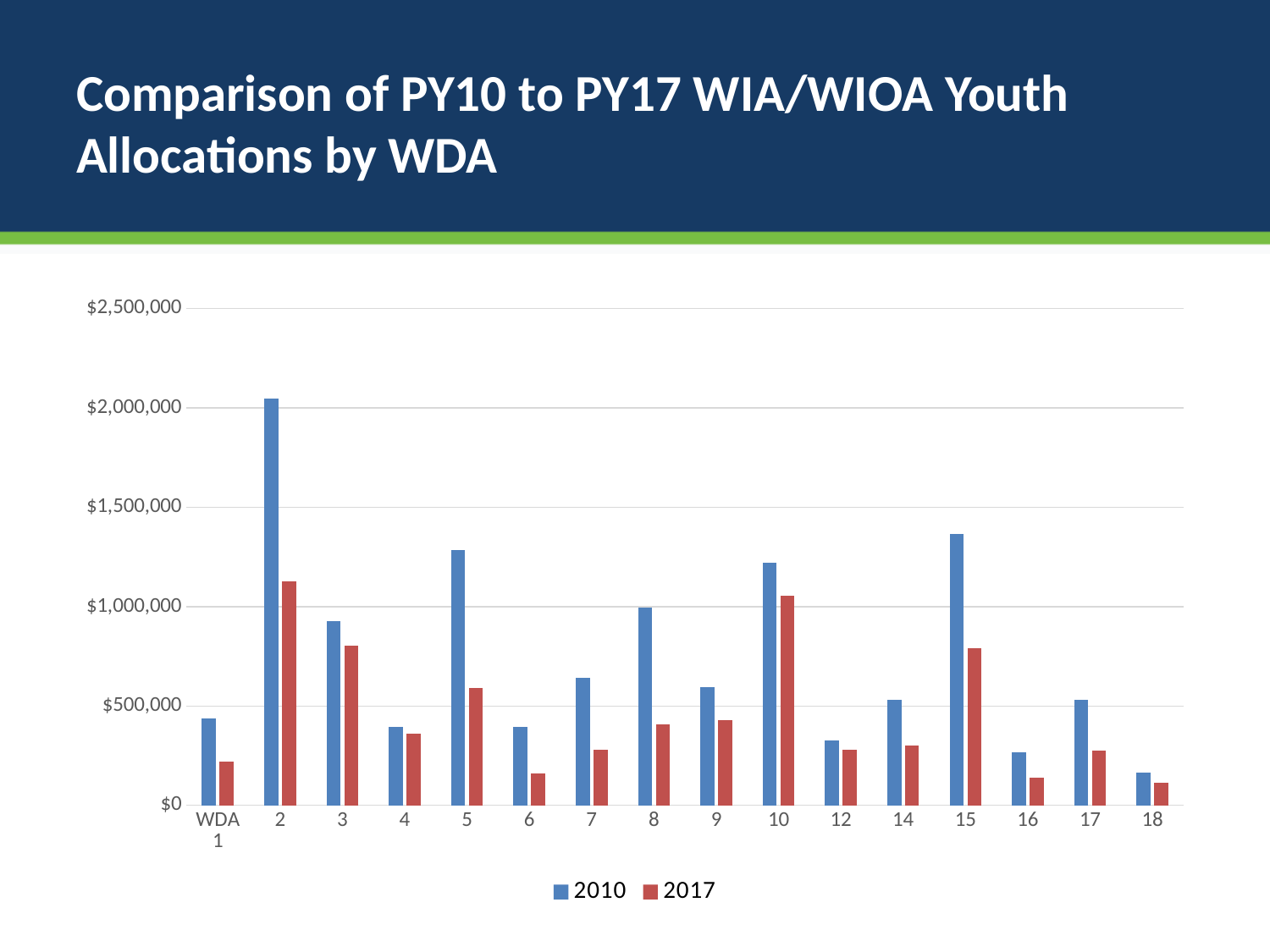
Which colour represents the 2017 series in the legend? red How many series does the legend list? 2 Which WDA has the highest 2010 allocation? 2 Is the 2010 value for WDA 3 greater or less than $1,000,000? less Which WDA has the highest 2017 allocation? 2 Which is larger for WDA 10: the 2010 value or the 2017 value? 2010 Is the 2010 value for WDA 5 greater or less than $1,000,000? greater Is the 2017 value for WDA 6 greater or less than $500,000? less How many WDA categories are shown on the x axis? 16 What kind of chart is shown on the slide? bar chart Which WDA has the lowest 2010 allocation? 18